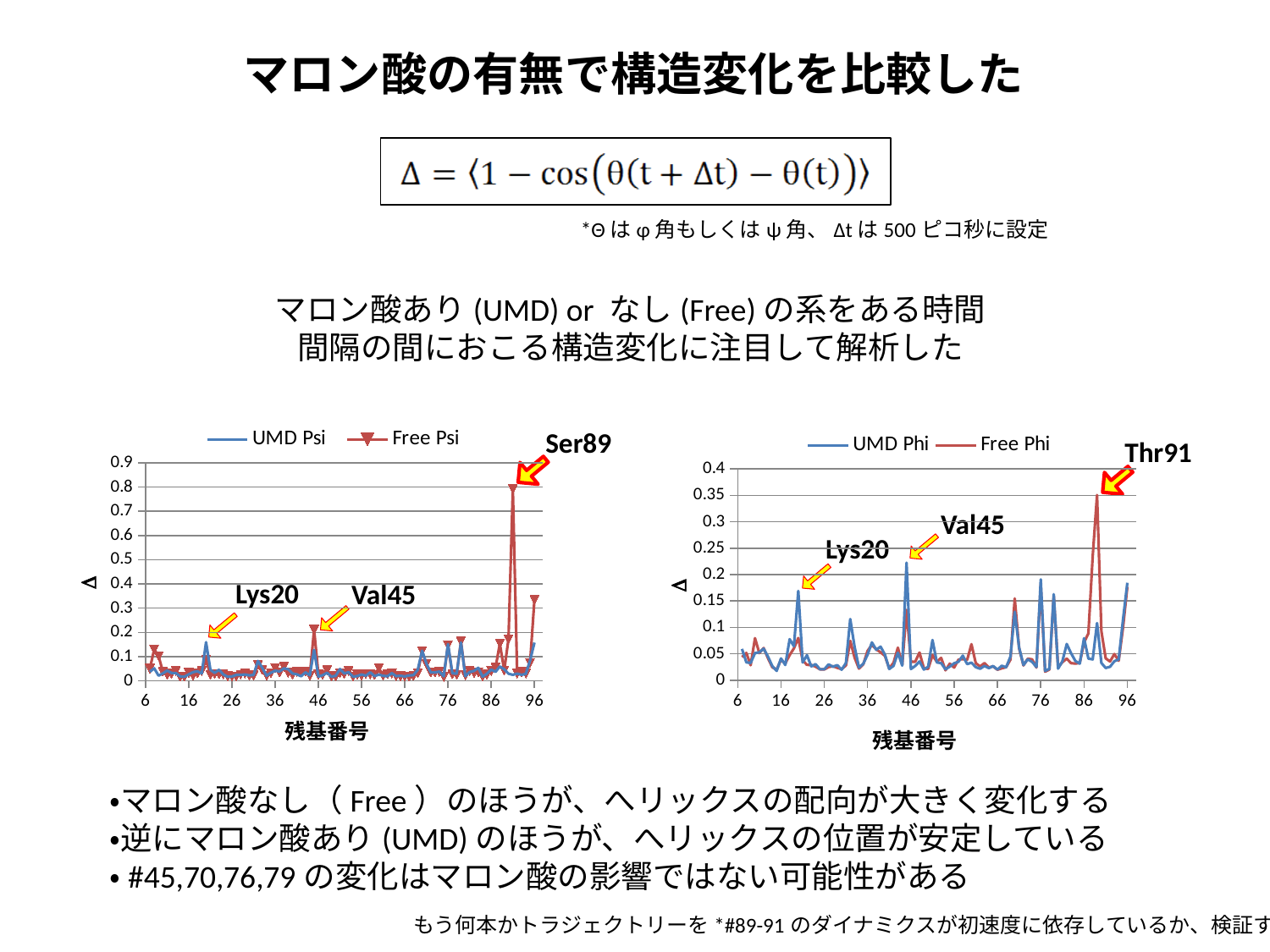
In the left chart, which series reaches the highest value, UMD Psi or Free Psi? Free Psi What is the maximum value shown on the y-axis of the right chart? 0.4 In the right chart, which series reaches the highest value, UMD Phi or Free Phi? Free Phi In the left chart, is the peak value of Free Psi at Ser89 greater or less than 0.7? greater In the right chart, is the peak value of Free Phi at Thr91 greater or less than 0.3? greater In the right chart, which residue is annotated at the highest peak? Thr91 How many series does the legend of the left chart list? 2 What kind of chart is the left chart (UMD Psi / Free Psi)? line chart In the left chart, is the value of UMD Psi at Lys20 greater or less than 0.2? less What are the two series named in the legend of the right chart? UMD Phi and Free Phi What is the maximum value shown on the y-axis of the left chart? 0.9